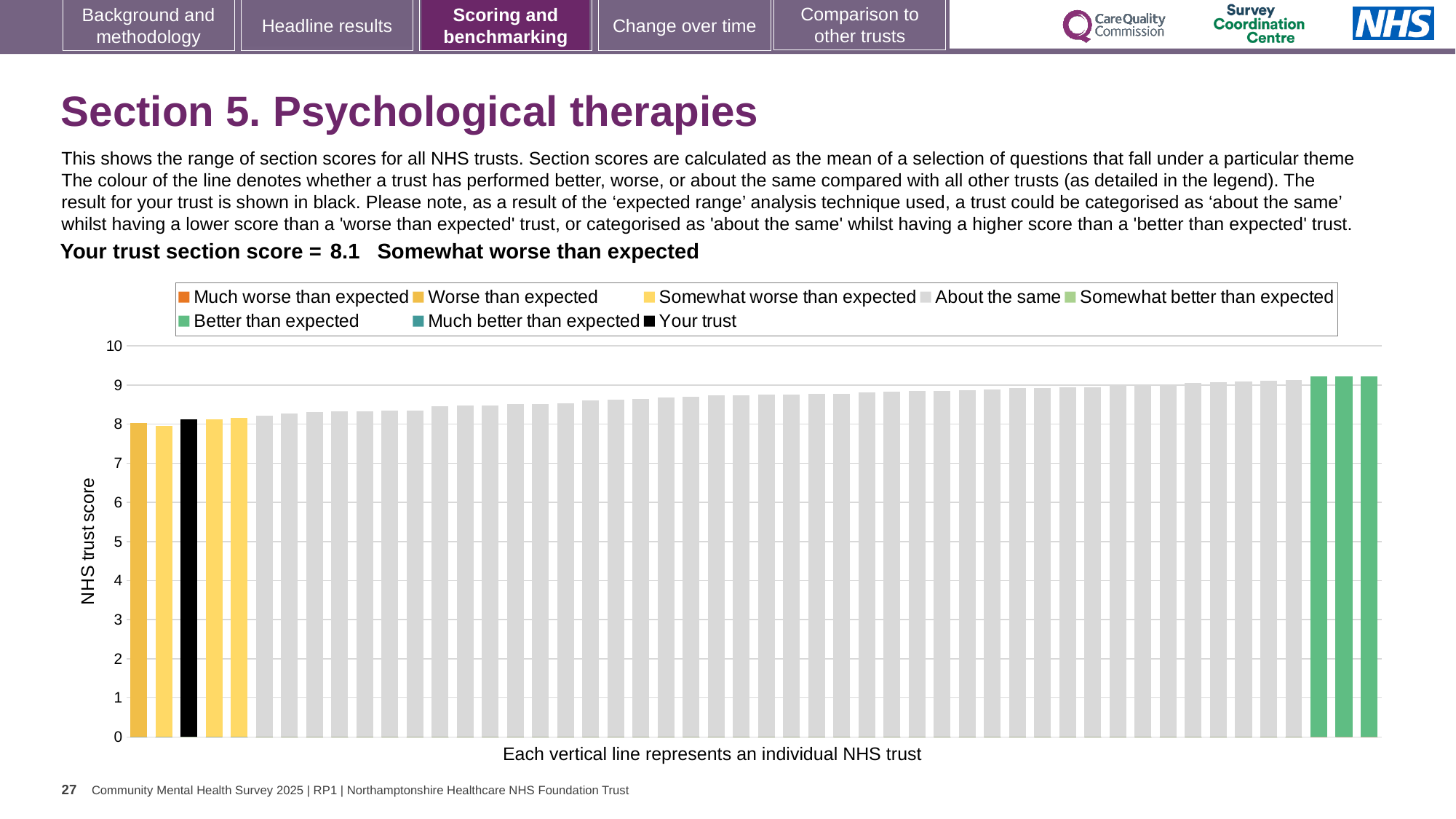
Is the value of the shortest bar in the chart greater or less than 9? less How many green 'Better than expected' bars are shown at the right of the chart? 3 Is the value of the tallest bar in the chart greater or less than 9? greater Is the value for your trust's bar greater or less than 5? greater Which category is your trust's section score placed in? Somewhat worse than expected What is the section score for your trust shown on the slide? 8.1 Do the bar values rise or fall from left to right along the x axis? Rise What colour is the bar representing your trust? Black What kind of chart is shown on the slide? Bar chart What is the highest value shown on the vertical axis? 10 How many entries does the chart legend list? 8 What is the label on the vertical axis of the chart? NHS trust score